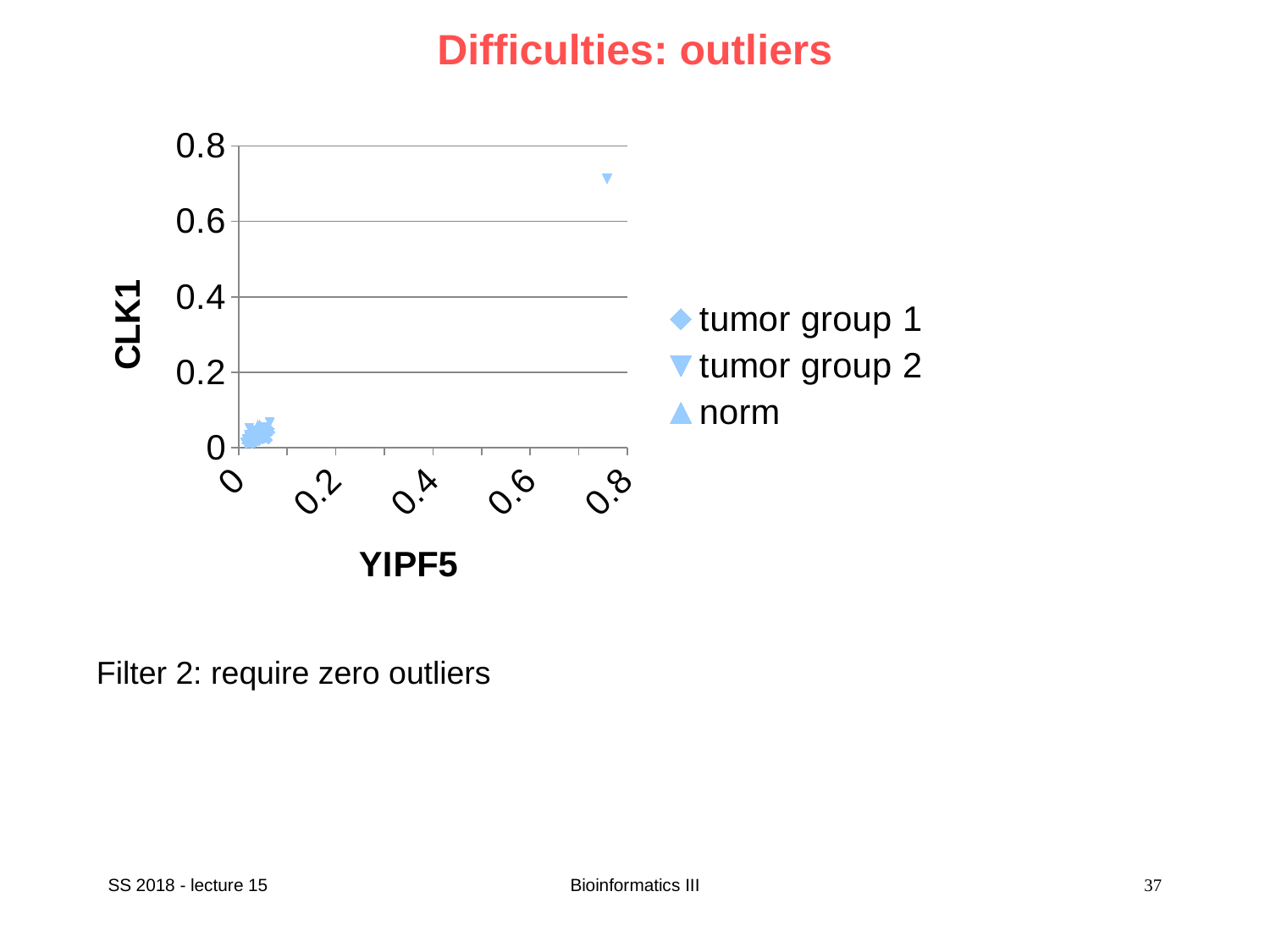
Is the CLK1 value of the isolated outlier point greater or less than 0.6? greater Are the CLK1 values of the main cluster of points greater or less than 0.2? less What is the label of the y axis? CLK1 Is the CLK1 value of the isolated outlier point greater or less than 0.8? less What is the label of the x axis? YIPF5 How many series does the legend list? 3 Which series does the isolated outlier point in the upper right belong to? tumor group 2 What is the highest tick value shown on the y axis? 0.8 What kind of chart is shown on the slide? scatter chart